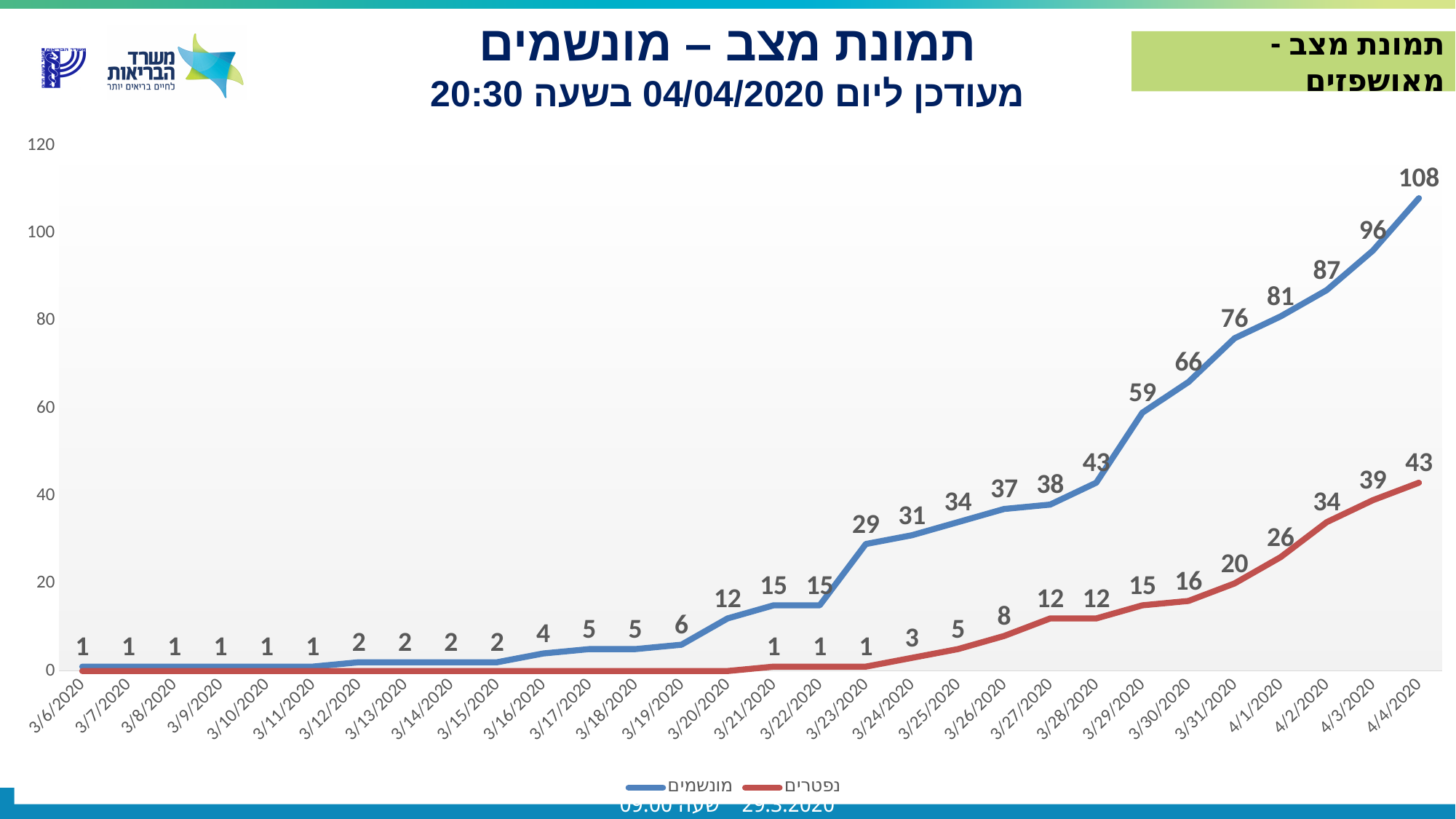
How many series does the legend list? 2 What type of chart is shown on the slide? line chart Which series has the larger value on 4/2/2020, מונשמים or נפטרים? מונשמים What is the difference between the מונשמים and נפטרים values on 4/4/2020? 65 Does the מונשמים series rise or fall from 3/6/2020 to 4/4/2020? rise How many dates are shown on the x axis? 30 On which date does the מונשמים series reach its highest value? 4/4/2020 What is the value of the נפטרים series on 3/31/2020? 20 What is the value of the מונשמים series on 4/4/2020? 108 What colour is the line for the נפטרים series? red What is the value of the מונשמים series on 3/23/2020? 29 What is the value of the נפטרים series on 4/4/2020? 43